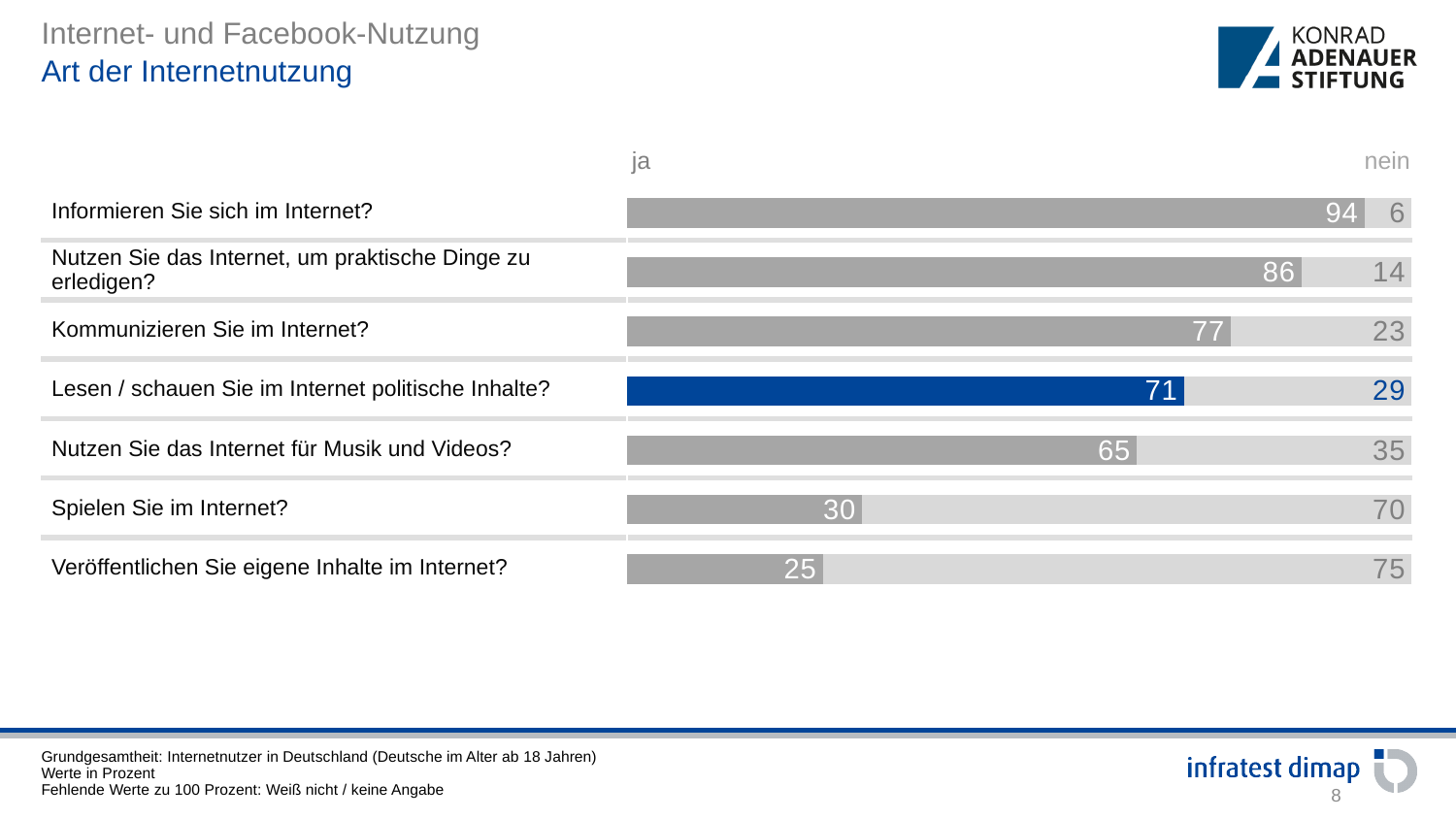
What is the total of the "ja" and "nein" values for "Nutzen Sie das Internet, um praktische Dinge zu erledigen?"? 100 Which question has the lowest "ja" share? Veröffentlichen Sie eigene Inhalte im Internet? Which question has the highest "ja" share? Informieren Sie sich im Internet? What is the difference between the "ja" values for "Kommunizieren Sie im Internet?" and "Nutzen Sie das Internet für Musik und Videos?"? 12 What percentage answered "ja" to "Informieren Sie sich im Internet?"? 94 What is the "ja" value for "Lesen / schauen Sie im Internet politische Inhalte?"? 71 How many questions (categories) are shown in the chart? 7 Which row of the chart is highlighted in blue? Lesen / schauen Sie im Internet politische Inhalte? How many series does the chart show? 2 What kind of chart is shown on the slide? Bar chart Which has a larger "nein" share: "Spielen Sie im Internet?" or "Nutzen Sie das Internet für Musik und Videos?"? Spielen Sie im Internet? What percentage answered "nein" to "Spielen Sie im Internet?"? 70